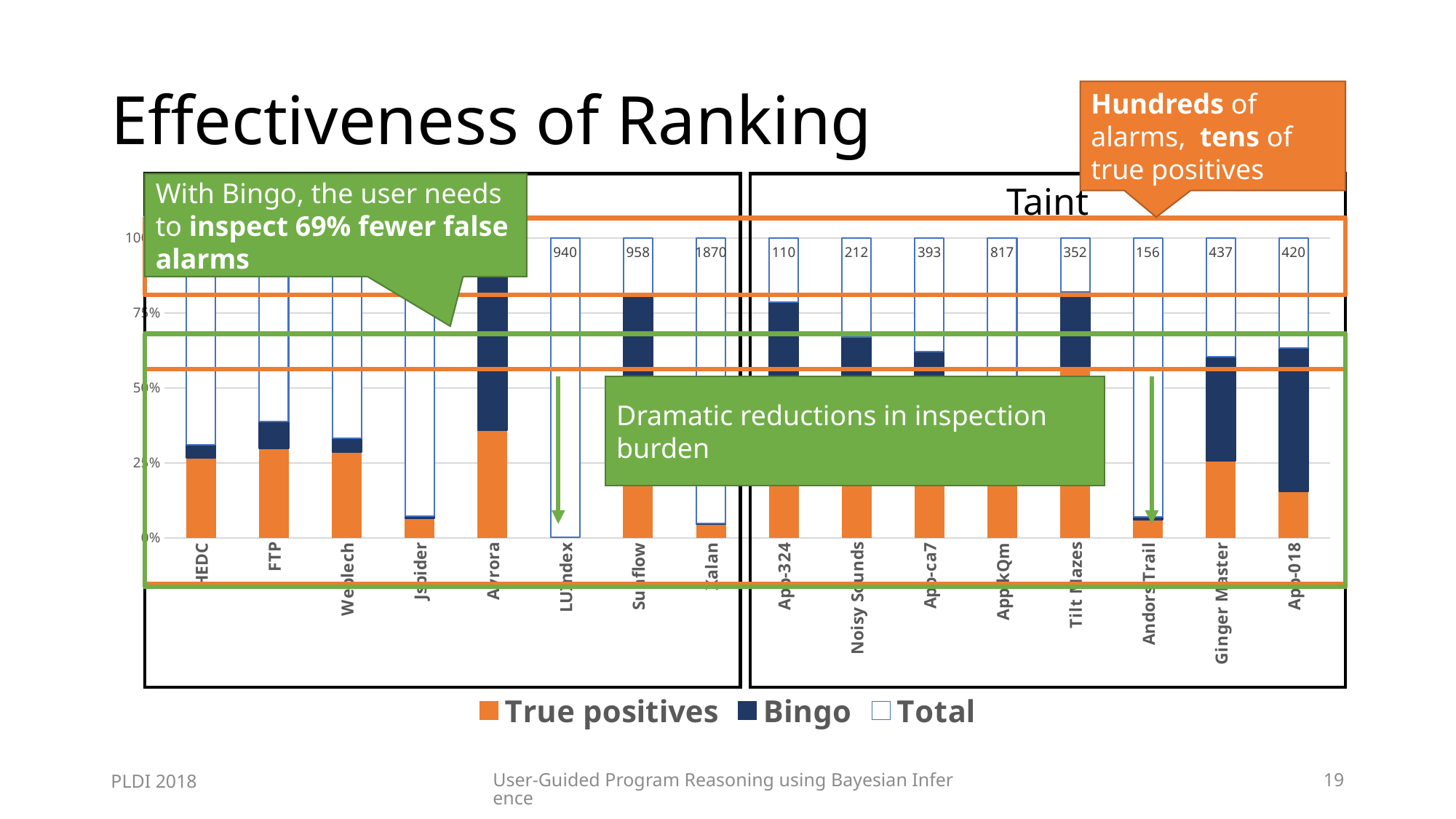
What is the Total value labelled for App-kQm? 817 In the Taint panel, which benchmark has the highest labelled Total? App-kQm Which colour represents True positives in the legend? orange What is the difference between the labelled Totals of Ginger Master and App-018? 17 What is the Total value labelled for Luindex? 940 Is the top of the stacked bar for Jspider greater or less than 25%? less How many series does the chart legend list? 3 Which has a larger labelled Total, Noisy Sounds or Tilt Mazes? Tilt Mazes What is the Total value labelled for Sunflow? 958 What is the Total value labelled for Andors Trail? 156 In the Taint panel, which benchmark has the lowest labelled Total? App-324 What kind of chart is shown on the slide? bar chart